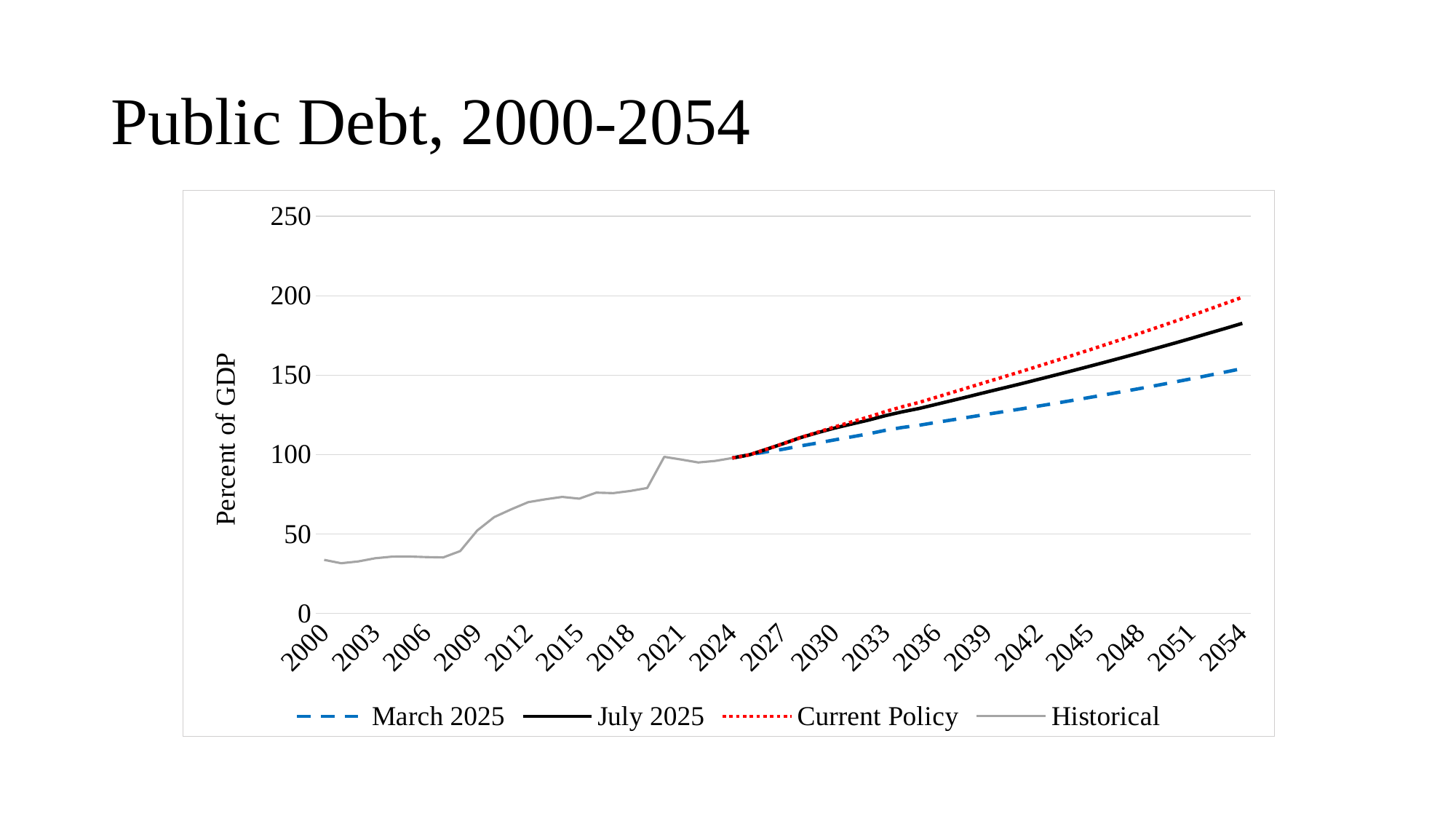
Is the value for July 2025 in 2054 greater or less than 200? less Is the Historical value in 2012 greater or less than 100? less What kind of chart is shown on the slide? line chart Is the Historical value in 2000 greater or less than 50? less Do the projected series rise or fall from 2024 to 2054? rise In 2054, which is larger: the Current Policy value or the March 2025 value? Current Policy What is the title of the chart? Public Debt, 2000-2054 How many series does the legend list? 4 How many year labels are shown along the x axis? 19 What is the label on the vertical axis? Percent of GDP